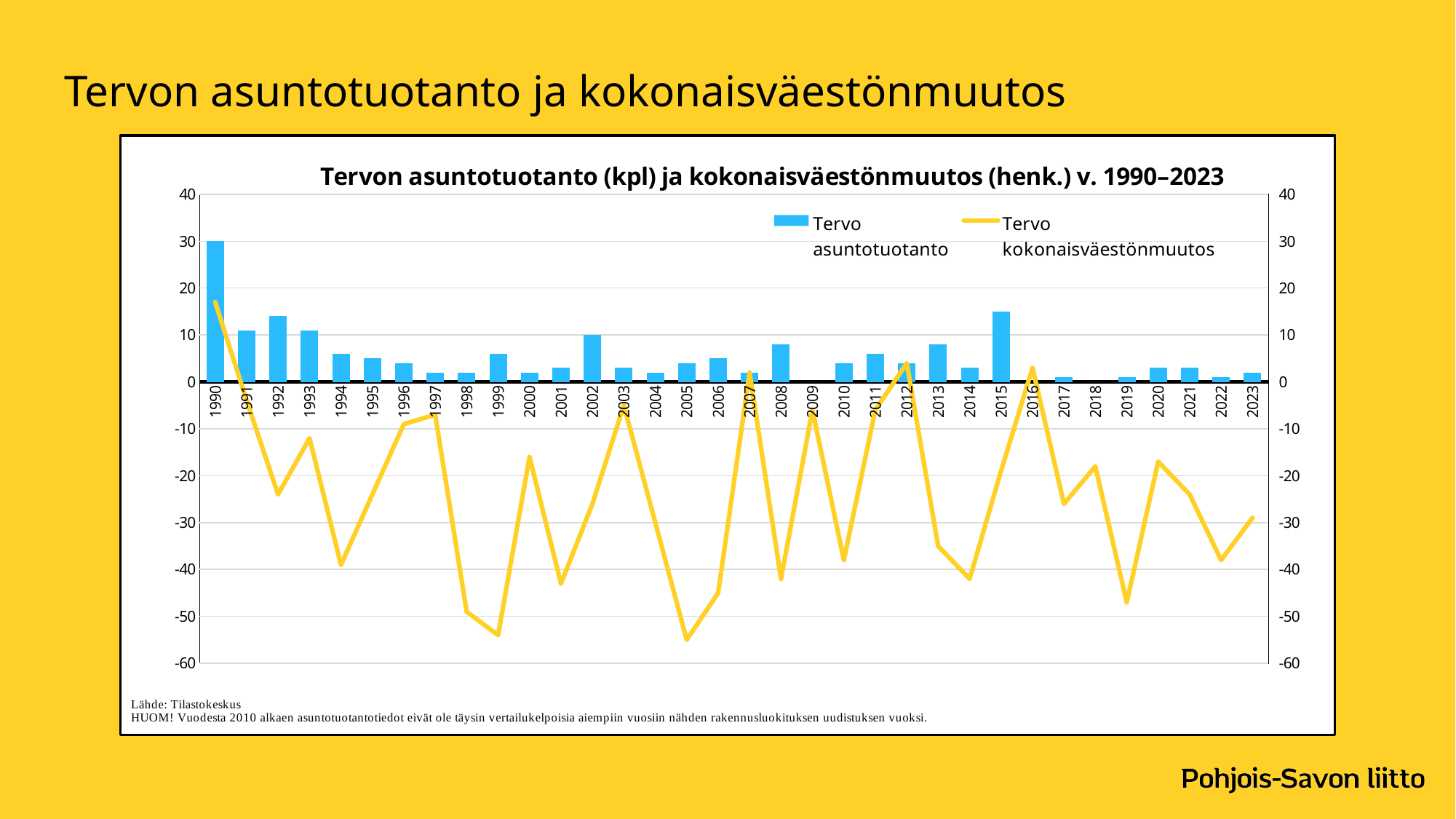
Is the Tervo asuntotuotanto bar for 2015 greater or less than 10? greater What colour is the Tervo kokonaisväestönmuutos line? Yellow Which is higher, the Tervo kokonaisväestönmuutos value for 1990 or for 1999? 1990 What kind of chart is shown on the slide? A combined bar and line chart Is the Tervo kokonaisväestönmuutos value for 2005 greater or less than -50? less Which is larger, the Tervo asuntotuotanto bar for 1992 or for 1991? 1992 How many years are shown on the x axis of the chart? 34 Which year has the highest bar for Tervo asuntotuotanto? 1990 What is the value of the Tervo asuntotuotanto bar for 1990? 30 How many series does the chart legend list? 2 Does the Tervo kokonaisväestönmuutos line rise or fall from 1990 to 1992? fall Is the Tervo kokonaisväestönmuutos value for 1990 greater or less than 10? greater